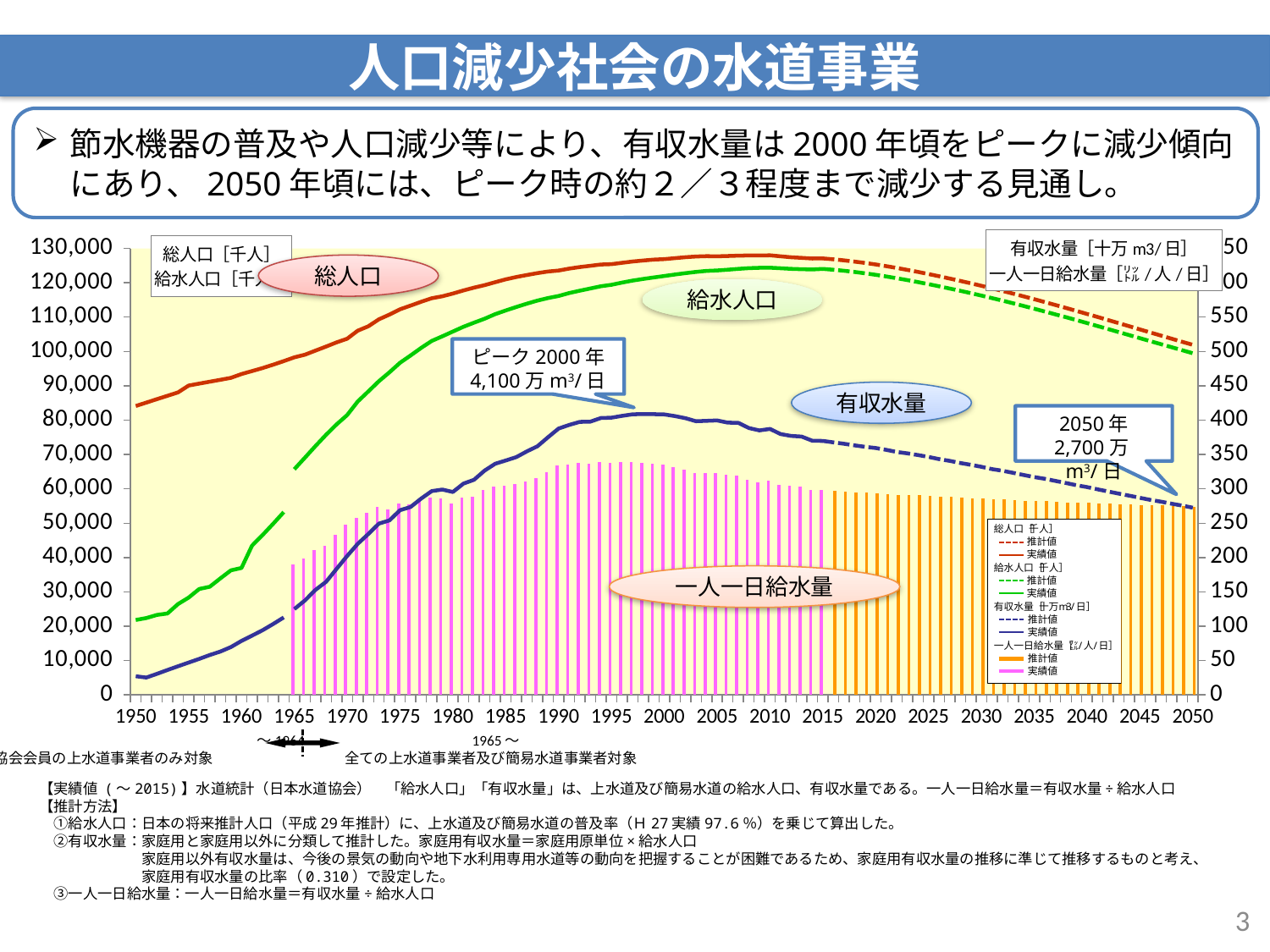
By how much is the 2050年 value of 有収水量 (2,700万 m³/日) lower than the 2000年 peak (4,100万 m³/日)? 1,400万 m³/日 Does the 総人口 line rise or fall from 1950 to 2000? Rises What peak value of 有収水量 is printed in the callout for 2000年? 4,100万 m³/日 Is the value of 総人口 in 1950 greater or less than 80,000? greater What kind of chart is shown on the slide? A combined line and bar chart Does the 有収水量 line rise or fall from 2000 to 2050? Falls What colour is the 総人口 line? Red In which year does the chart mark the peak of 有収水量? 2000年 Is the value of 給水人口 in 1950 greater or less than 30,000? less In 1950, which is larger, 総人口 or 給水人口? 総人口 What value of 有収水量 is printed in the callout for 2050年? 2,700万 m³/日 Which series has the highest values across the whole chart? 総人口